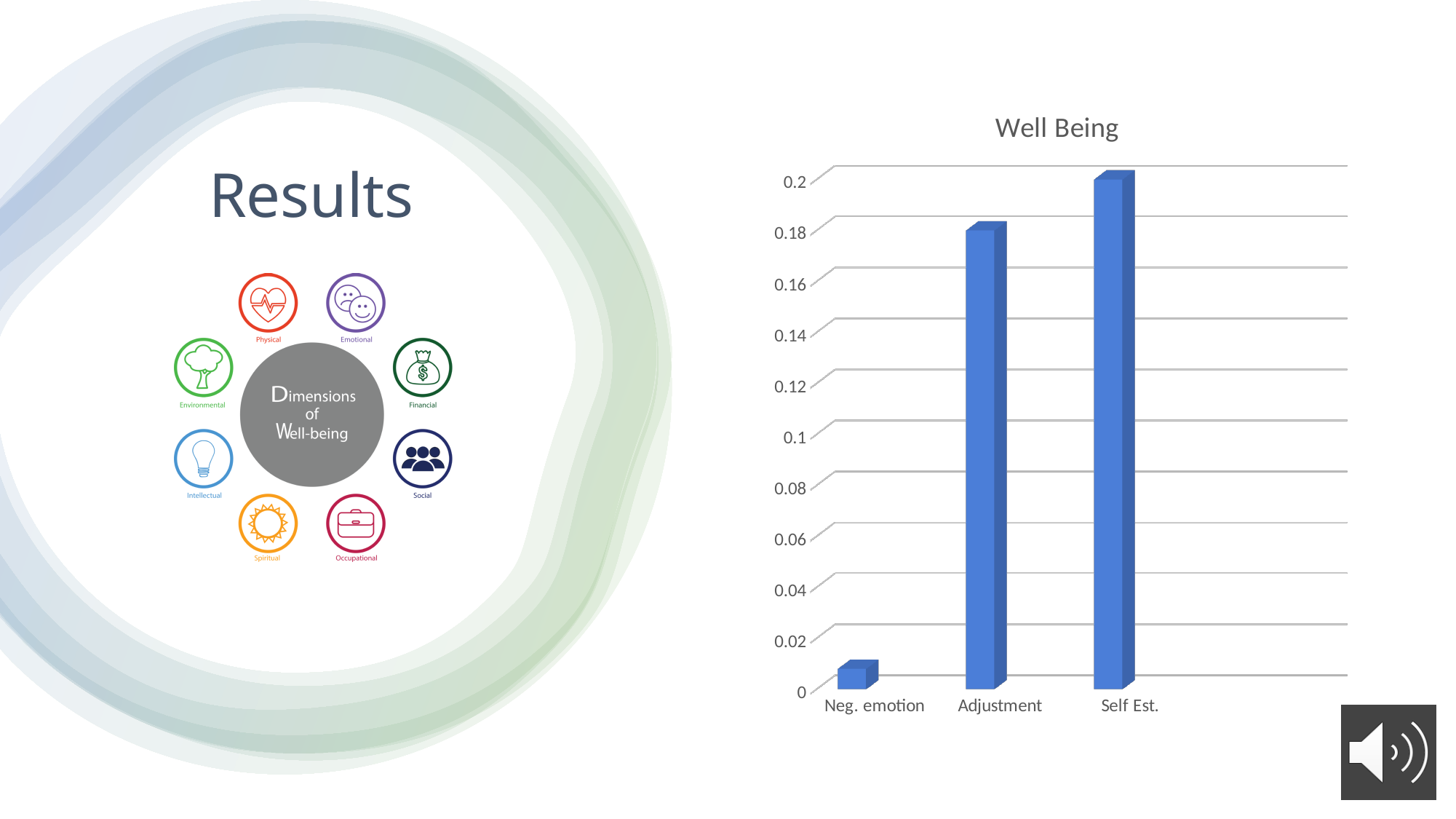
In the Well Being chart, which is larger, the value for Adjustment or the value for Neg. emotion? Adjustment In the Well Being chart, is the value for Neg. emotion greater or less than 0.02? less In the Well Being chart, which is larger, the value for Self Est. or the value for Adjustment? Self Est. In the Well Being chart, is the value for Self Est. greater or less than 0.16? greater What kind of chart is shown under the title "Well Being"? bar chart Which category has the highest value in the Well Being chart? Self Est. Do the values in the Well Being chart rise or fall from left to right along the x axis? rise What is the highest value shown on the vertical axis of the Well Being chart? 0.2 What is the title of the chart on the slide? Well Being Which category has the lowest value in the Well Being chart? Neg. emotion In the Well Being chart, is the value for Adjustment greater or less than 0.1? greater How many categories are plotted in the Well Being chart? 3